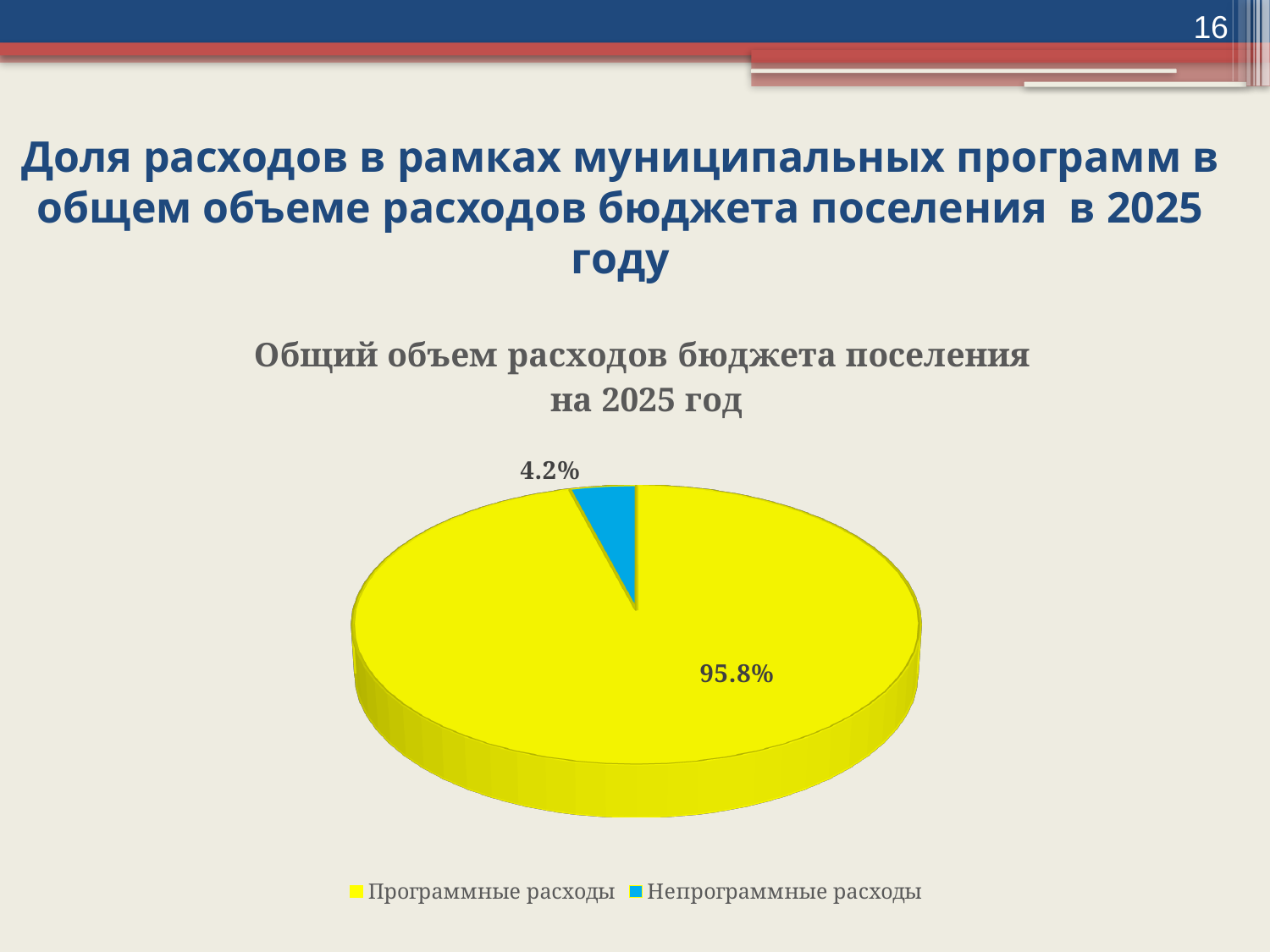
What is the difference in percentage points between Программные расходы and Непрограммные расходы? 91.6 What colour is the slice for Непрограммные расходы? Blue What share of the pie does Непрограммные расходы take? 4.2% How many slices does the pie chart have? 2 What kind of chart is shown on the slide? Pie chart What share of the pie does Программные расходы take? 95.8% Which is larger, Программные расходы or Непрограммные расходы? Программные расходы What is the title of the chart? Общий объем расходов бюджета поселения на 2025 год How many entries does the legend list? 2 Which category has the smallest slice of the pie? Непрограммные расходы Which category has the largest slice of the pie? Программные расходы